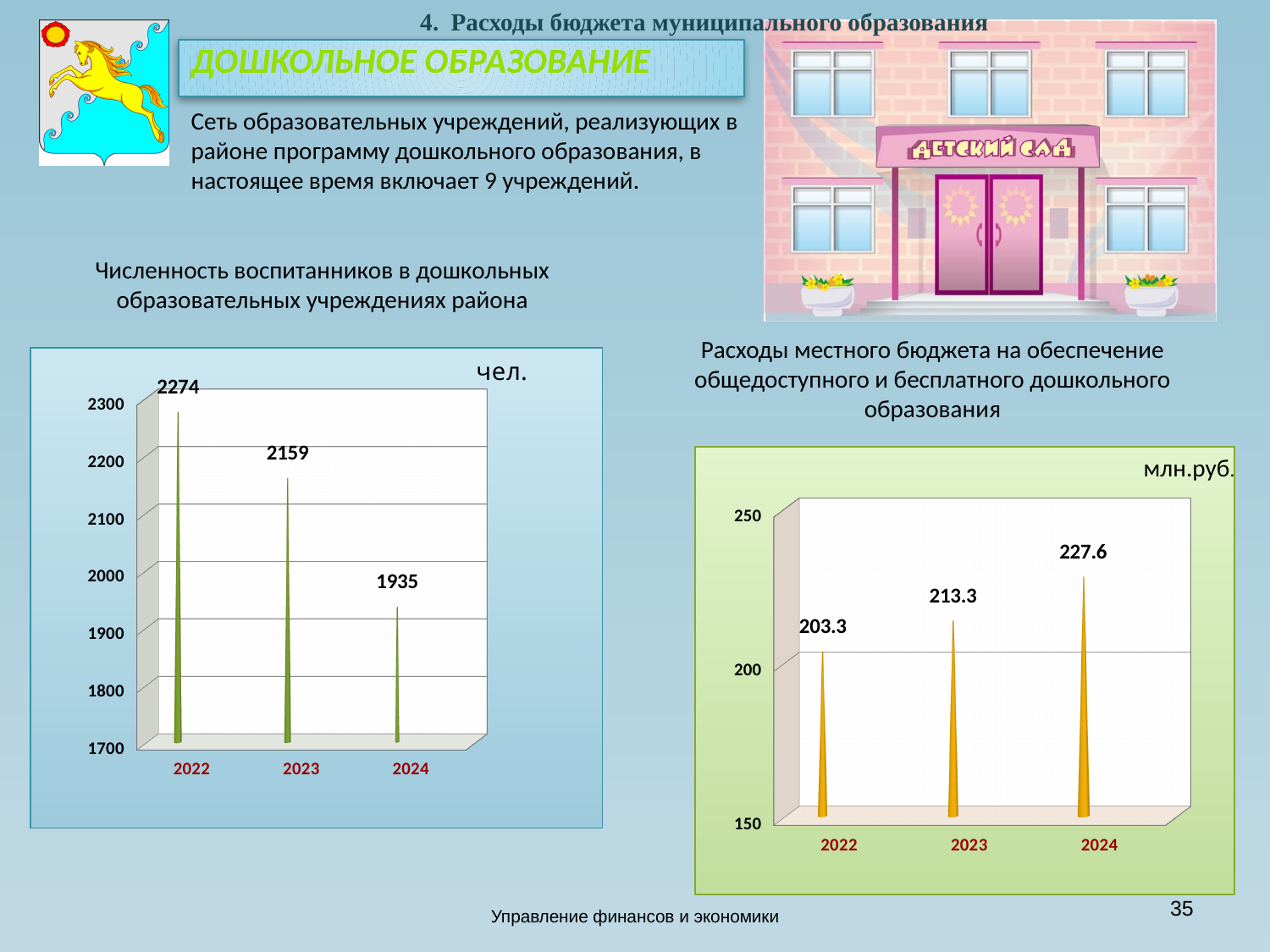
On the right chart (Расходы местного бюджета), what is the value for 2023? 213.3 On the left chart (Численность воспитанников), which year has the lowest value? 2024 On the right chart (Расходы местного бюджета), is the value for 2022 greater or less than 200? greater On the left chart (Численность воспитанников), what is the difference between the 2022 and 2023 values? 115 On the left chart (Численность воспитанников), how many years are shown? 3 On the right chart (Расходы местного бюджета), what is the difference between the 2024 and 2022 values? 24.3 On the right chart (Расходы местного бюджета), do the values rise or fall from 2022 to 2024? rise On the left chart (Численность воспитанников), what is the value for 2024? 1935 What unit is shown on the right chart (Расходы местного бюджета)? млн.руб. On the right chart (Расходы местного бюджета), which year has the highest value? 2024 On the left chart (Численность воспитанников), do the values rise or fall from 2022 to 2024? fall On the left chart (Численность воспитанников), what is the value for 2022? 2274